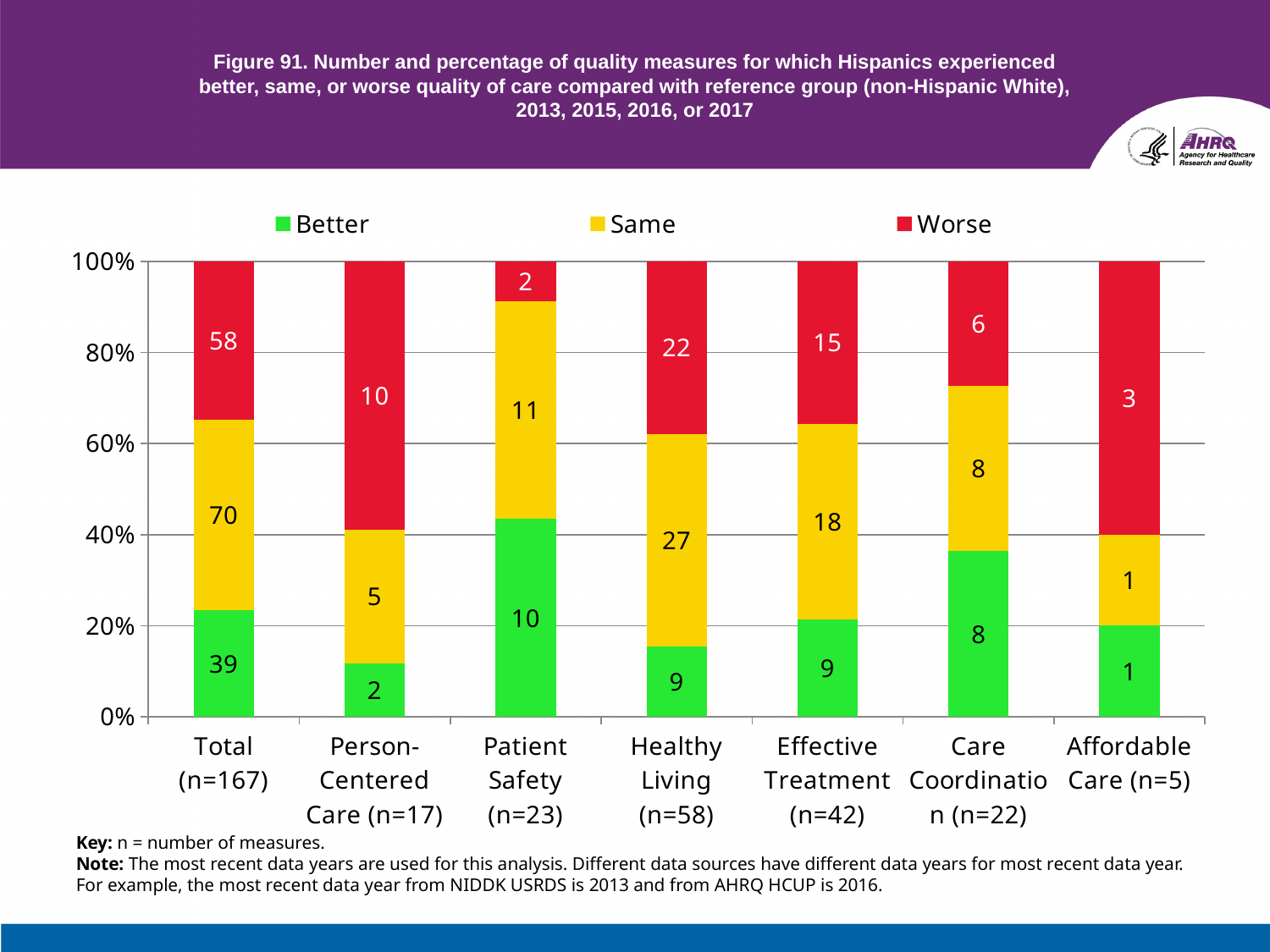
How many series does the legend list? 3 How many categories are shown along the x axis? 7 What is the Same value for Healthy Living (n=58)? 27 What is the difference between the Same and Better values for Effective Treatment (n=42)? 9 What is the total of the stacked bar for Person-Centered Care (n=17)? 17 What is the Better value for Care Coordination (n=22)? 8 Excluding Total, which category has the highest Worse value? Healthy Living (n=58) Which is larger for Patient Safety (n=23): the Same value or the Worse value? Same Is the Better segment for Person-Centered Care (n=17) greater or less than 20% of the bar? less What is the Worse value for Total (n=167)? 58 Which category has the lowest Same value? Affordable Care (n=5) What type of chart is shown on the slide? Stacked bar chart